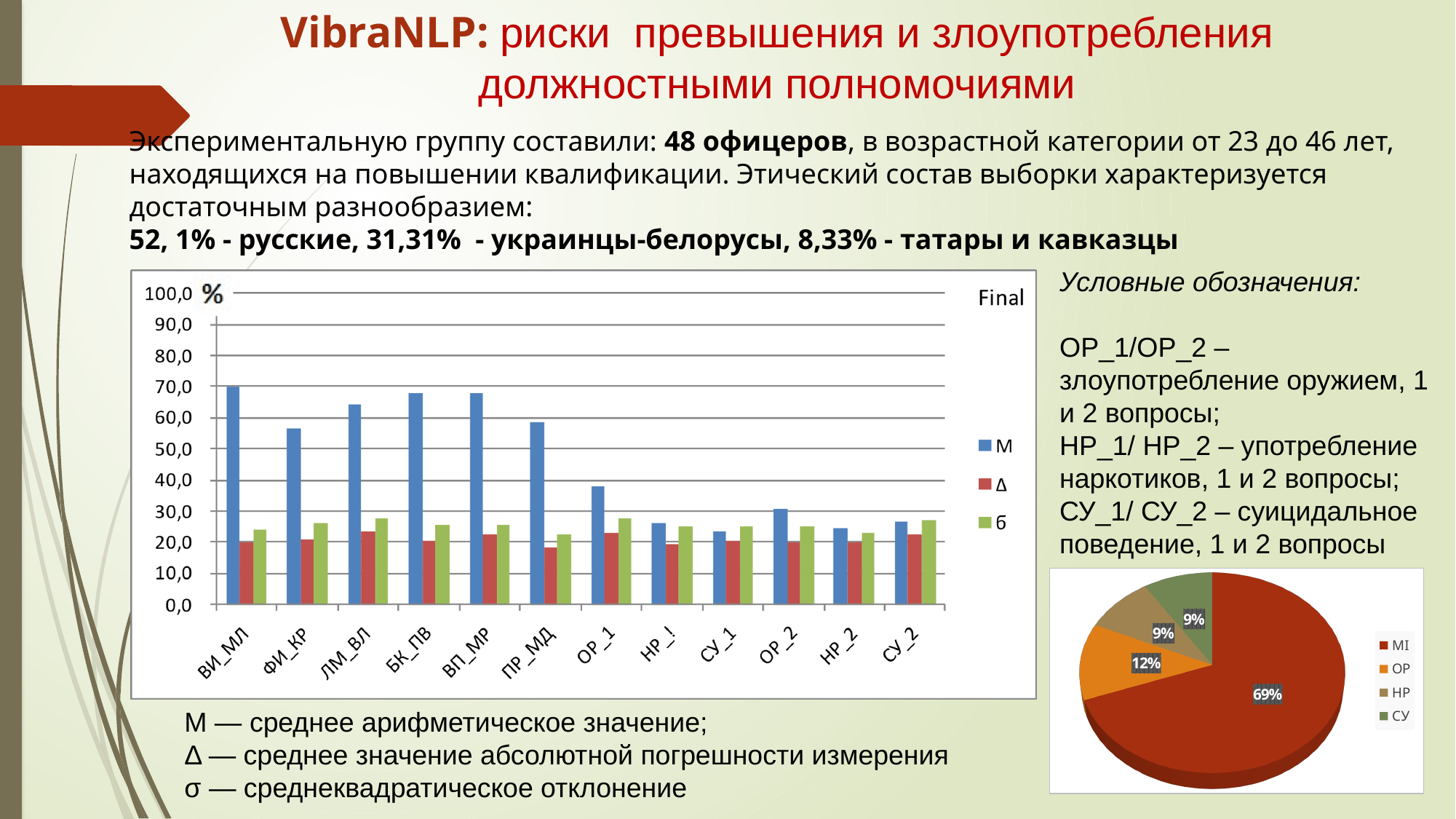
What kind of chart is the chart on the left of the slide (titled "Final")? bar chart In the "Final" bar chart, which has the larger M value, ВИ_МЛ or ОР_1? ВИ_МЛ In the "Final" bar chart, how many series does the legend list? 3 In the "Final" bar chart, is the M value for ОР_1 greater or less than 30? greater What kind of chart is the chart in the lower right of the slide? pie chart In the "Final" bar chart, is the M value for ВИ_МЛ greater or less than 60? greater In the pie chart, which slice is the largest? MI In the "Final" bar chart, which has the larger M value, ОР_2 or СУ_2? ОР_2 In the pie chart, what is the difference in percentage points between the MI slice and the OP slice? 57 In the pie chart, what share does the OP slice have? 12% In the "Final" bar chart, how many categories are shown on the x axis? 12 In the "Final" bar chart, is the M value for СУ_1 greater or less than 30? less